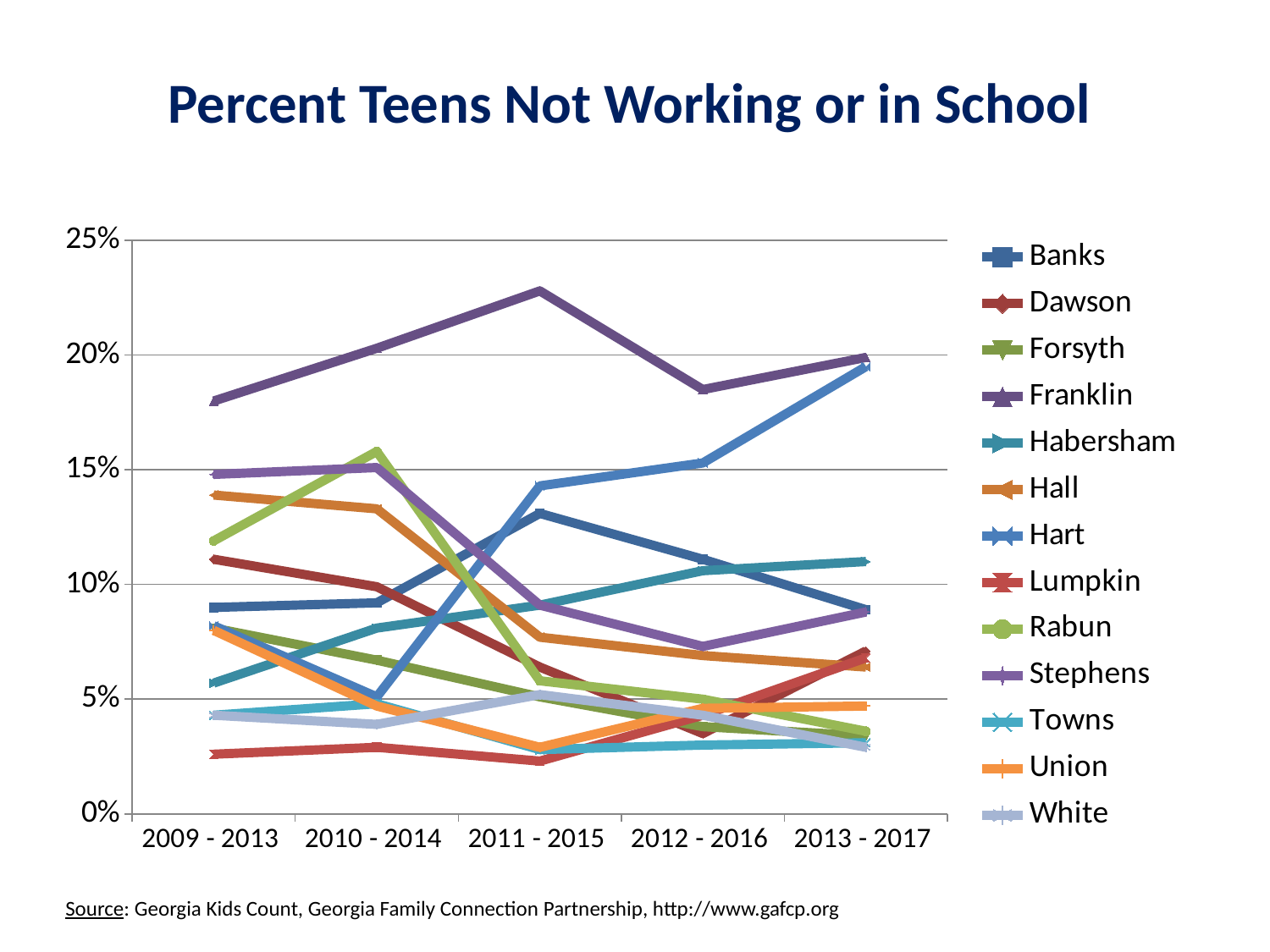
Does the value for Habersham rise or fall from 2009 - 2013 to 2013 - 2017? rise How many time periods are shown on the x axis? 5 In 2009 - 2013, which is larger, the value for Franklin or the value for Banks? Franklin Is the value for Lumpkin in 2009 - 2013 greater or less than 5%? less What is the title of the chart? Percent Teens Not Working or in School How many series does the legend list? 13 Is the value for Franklin in 2011 - 2015 greater or less than 20%? greater Is the value for Hart in 2013 - 2017 greater or less than 15%? greater What kind of chart is shown on the slide? line chart Which county has the highest value in 2011 - 2015? Franklin Which county has the lowest value in 2009 - 2013? Lumpkin Does the value for Hall rise or fall from 2009 - 2013 to 2013 - 2017? fall